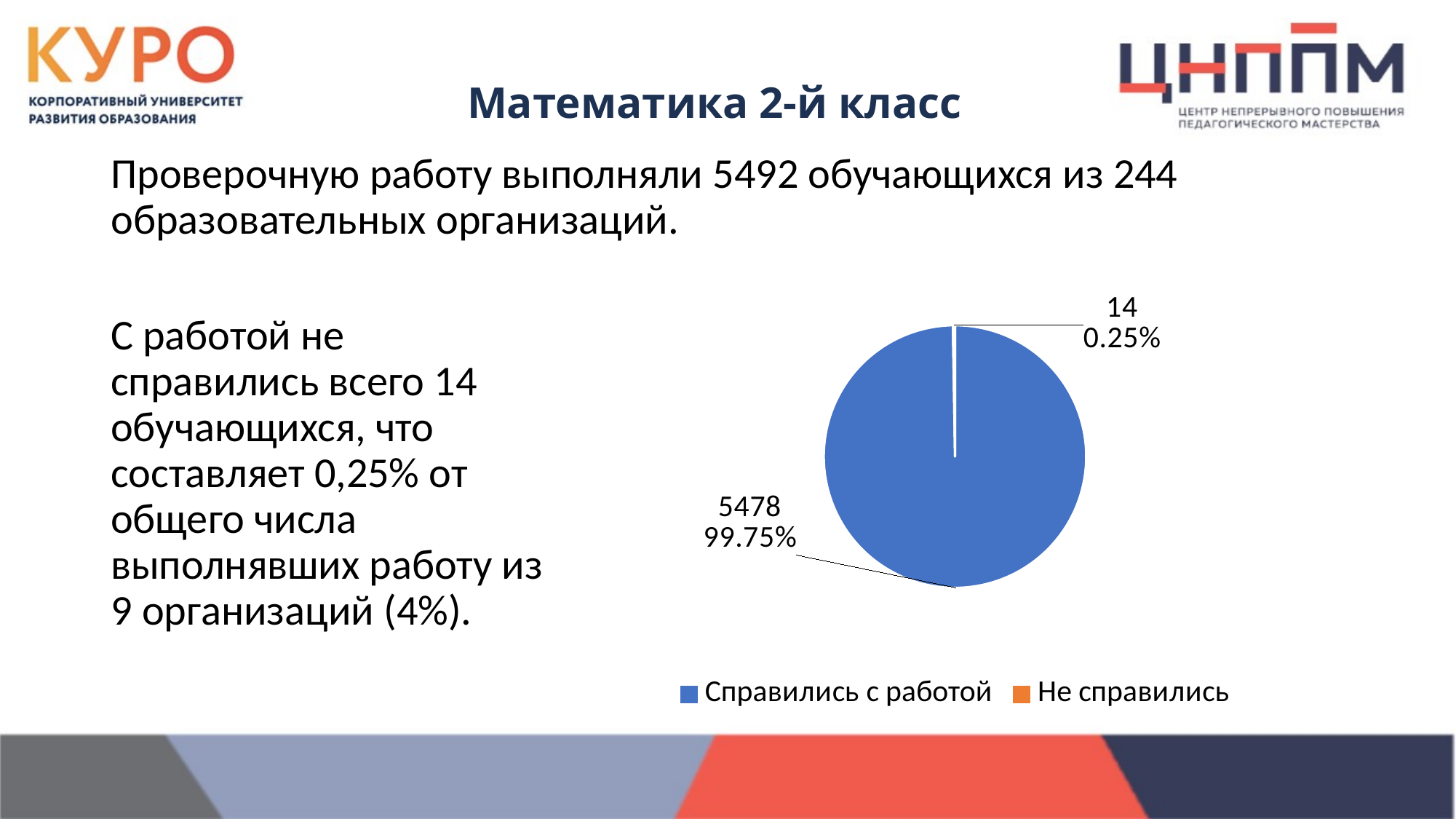
Which slice of the pie chart is the smallest? Не справились What kind of chart is shown on the slide? Pie chart How many entries does the legend of the pie chart list? 2 What share of the pie does "Не справились" represent? 0.25% What colour is the "Справились с работой" slice in the pie chart? Blue How many slices does the pie chart have? 2 What is the value for "Справились с работой" in the pie chart? 5478 What share of the pie does "Справились с работой" represent? 99.75% What is the value for "Не справились" in the pie chart? 14 Which slice of the pie chart is the largest? Справились с работой Which is larger: the value for "Справились с работой" or for "Не справились"? Справились с работой What is the difference between the values for "Справились с работой" and "Не справились"? 5464